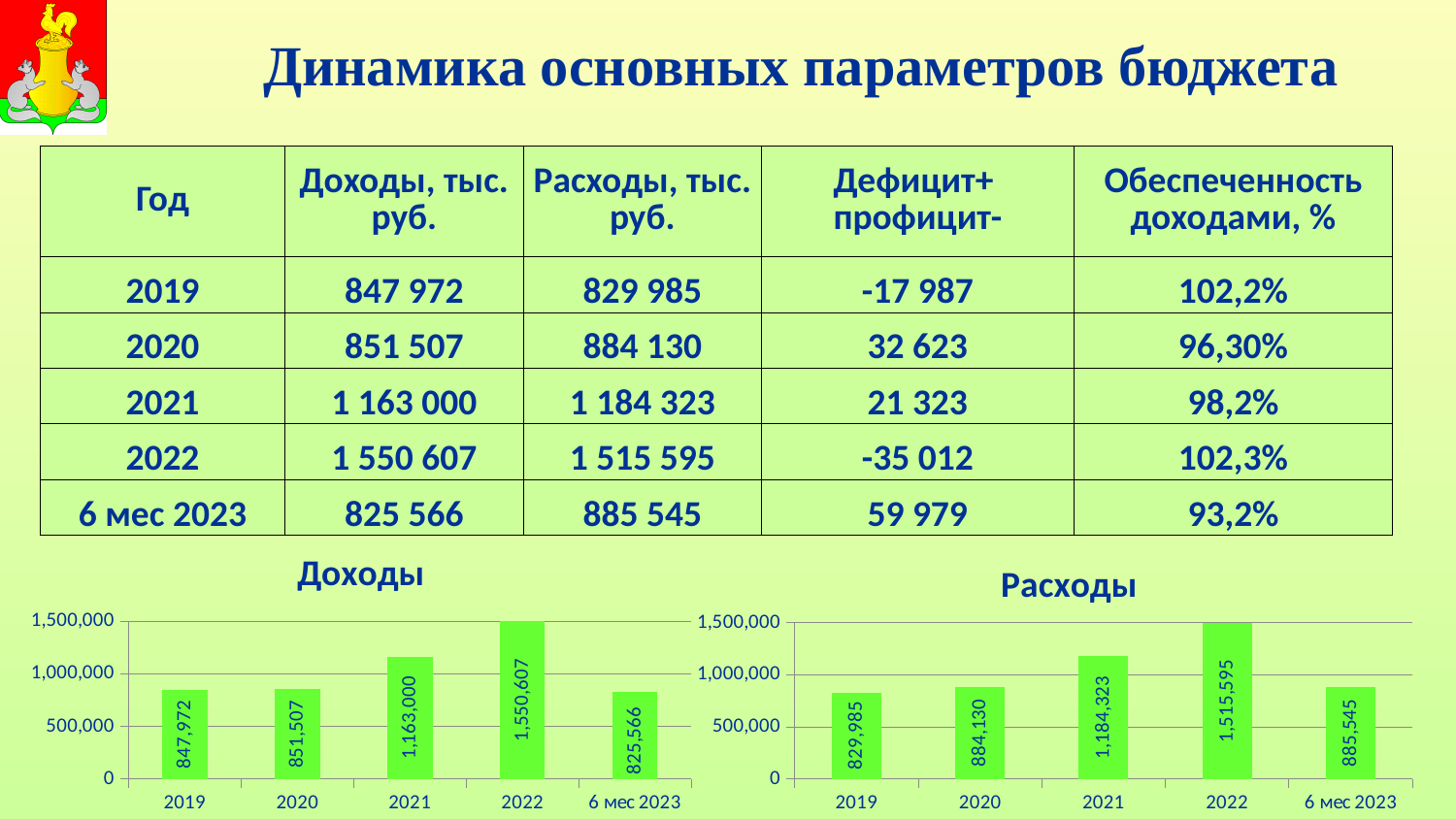
In the "Расходы" chart, is the value for 2022 greater or less than 1,000,000? greater In the "Расходы" chart, which category has the lowest value? 2019 In the "Расходы" chart, what is the value for 2020? 884,130 How many bars are shown in the "Доходы" chart? 5 In the "Расходы" chart, what is the value for 6 мес 2023? 885,545 In the "Доходы" chart, does the value rise or fall from 2022 to 6 мес 2023? fall In the "Доходы" chart, what is the difference between the values for 2022 and 2021? 387,607 What type of chart is the "Расходы" chart? bar chart In the "Доходы" chart, which year has the highest value? 2022 In the "Доходы" chart, what is the value for 2021? 1,163,000 In the "Расходы" chart, which is larger: the value for 2021 or the value for 2022? 2022 What is the title of the chart on the left side of the slide? Доходы